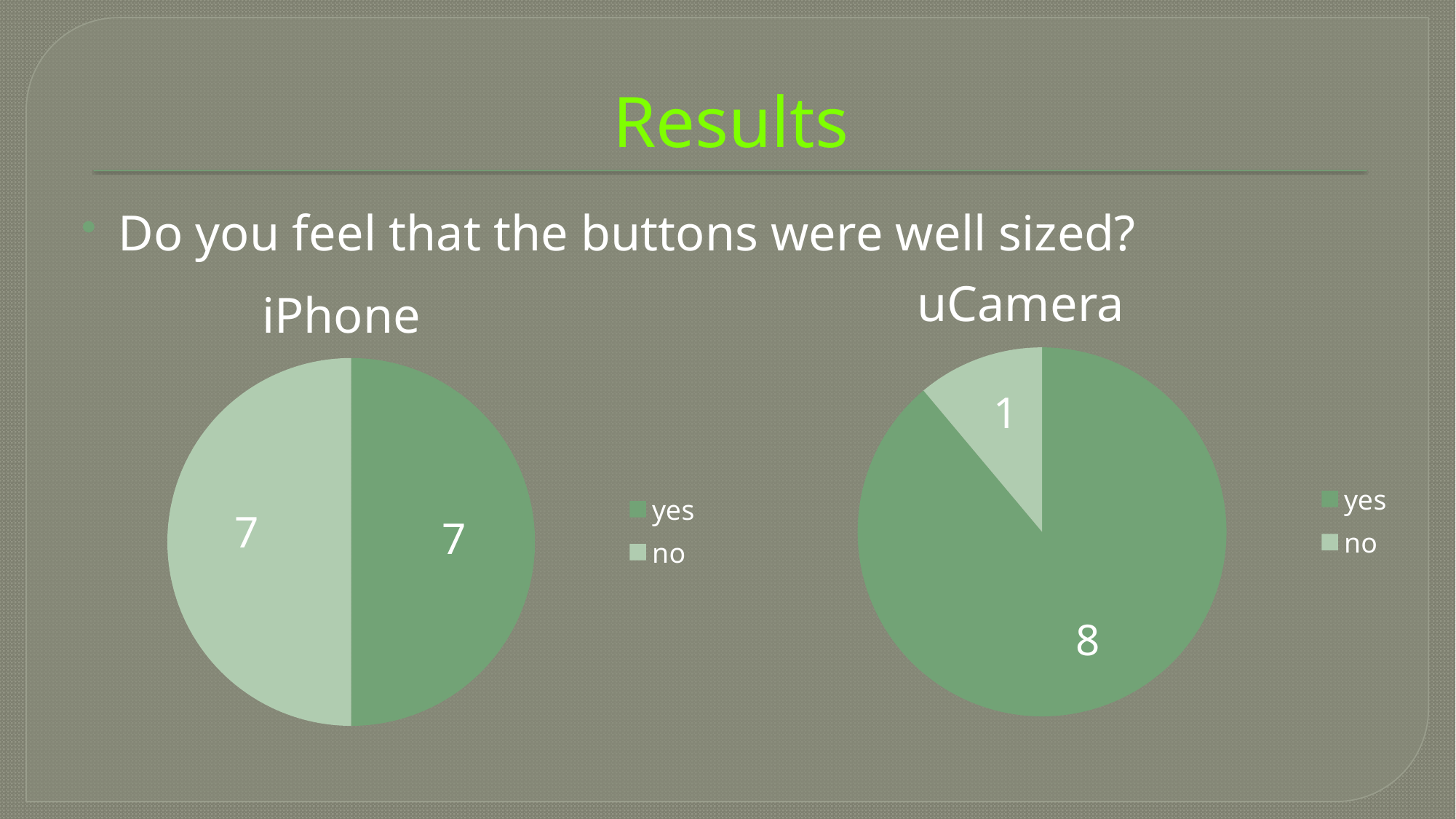
What kind of chart is the iPhone chart? pie chart In the uCamera chart, is the value for "yes" larger or smaller than the value for "no"? larger In the uCamera chart, what is the value for "yes"? 8 What is the title of the chart on the right side of the slide? uCamera In the uCamera chart, which category is the largest? yes In the uCamera chart, what is the value for "no"? 1 In the uCamera chart, which category is the smallest? no In the iPhone chart, what is the value for "no"? 7 How many categories does the uCamera chart's legend list? 2 In the uCamera chart, what is the difference between the "yes" and "no" values? 7 In the iPhone chart, what is the value for "yes"? 7 In the iPhone chart, what is the total of all slices? 14